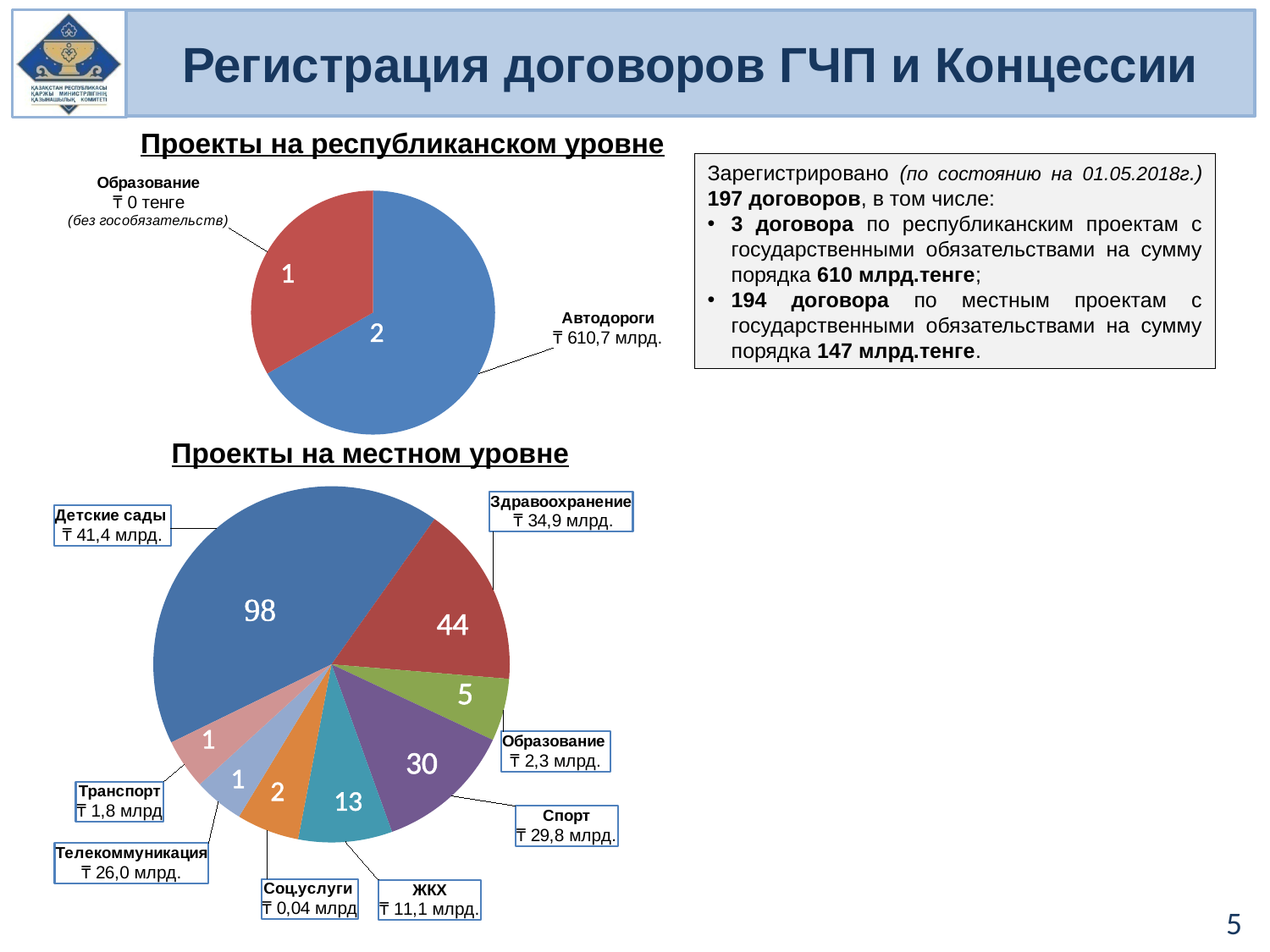
In the chart 'Проекты на местном уровне', what amount is labelled for Телекоммуникация? ₸ 26,0 млрд. In the chart 'Проекты на местном уровне', which category has the largest slice? Детские сады In the chart 'Проекты на республиканском уровне', how many contracts are shown for Автодороги? 2 In the chart 'Проекты на местном уровне', what is the difference between the number of contracts for Здравоохранение and ЖКХ? 31 What type of chart is 'Проекты на местном уровне'? pie chart In the chart 'Проекты на местном уровне', how many contracts are shown for Детские сады? 98 In the chart 'Проекты на местном уровне', which has more contracts, Образование or Соц.услуги? Образование In the chart 'Проекты на местном уровне', how many contracts are shown for Спорт? 30 In the chart 'Проекты на местном уровне', how many categories are shown? 8 In the chart 'Проекты на местном уровне', what is the total number of contracts across all slices? 194 In the chart 'Проекты на республиканском уровне', what amount is labelled for Автодороги? ₸ 610,7 млрд. In the chart 'Проекты на республиканском уровне', how many slices does the pie have? 2